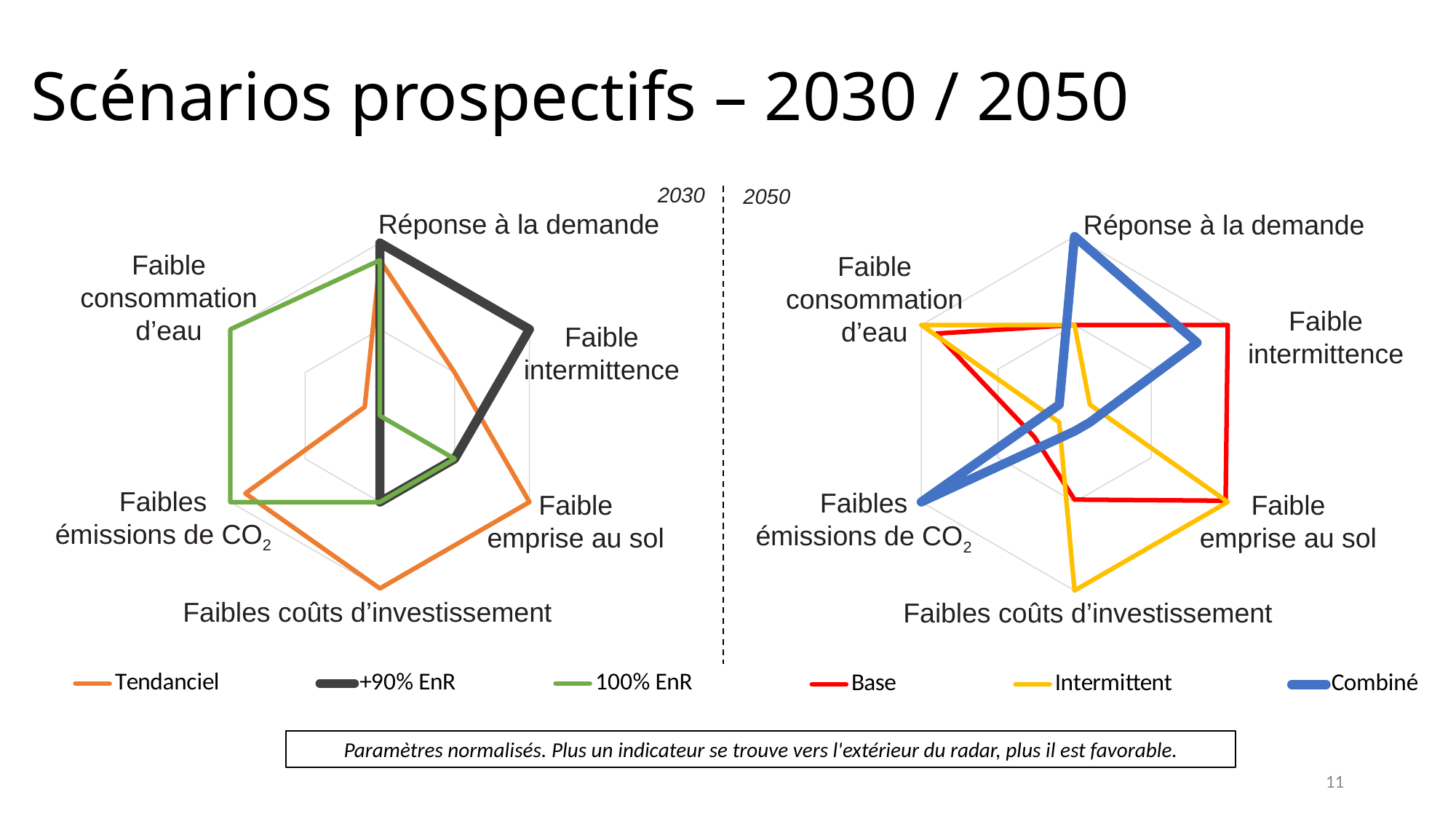
In the 2030 radar chart, how many scenarios does the legend list? 3 In the 2050 radar chart, which scenario scores highest on Faibles émissions de CO2? Combiné What are the three legend entries of the 2050 radar chart? Base, Intermittent, Combiné In the 2050 radar chart, how many scenarios does the legend list? 3 In the 2050 radar chart, which scenario scores higher on Faibles coûts d'investissement: Intermittent or Base? Intermittent In the 2050 radar chart, which scenario scores highest on Réponse à la demande? Combiné In the 2030 radar chart, which scenario scores higher on Faible emprise au sol: Tendanciel or 100% EnR? Tendanciel In the 2030 radar chart, which scenario scores higher on Faible intermittence: +90% EnR or 100% EnR? +90% EnR In the 2030 radar chart, which scenario scores highest on Faibles coûts d'investissement? Tendanciel In the 2030 radar chart, how many indicators (axes) are plotted? 6 What kind of chart is used on this slide for the 2030 and 2050 scenarios? Radar chart